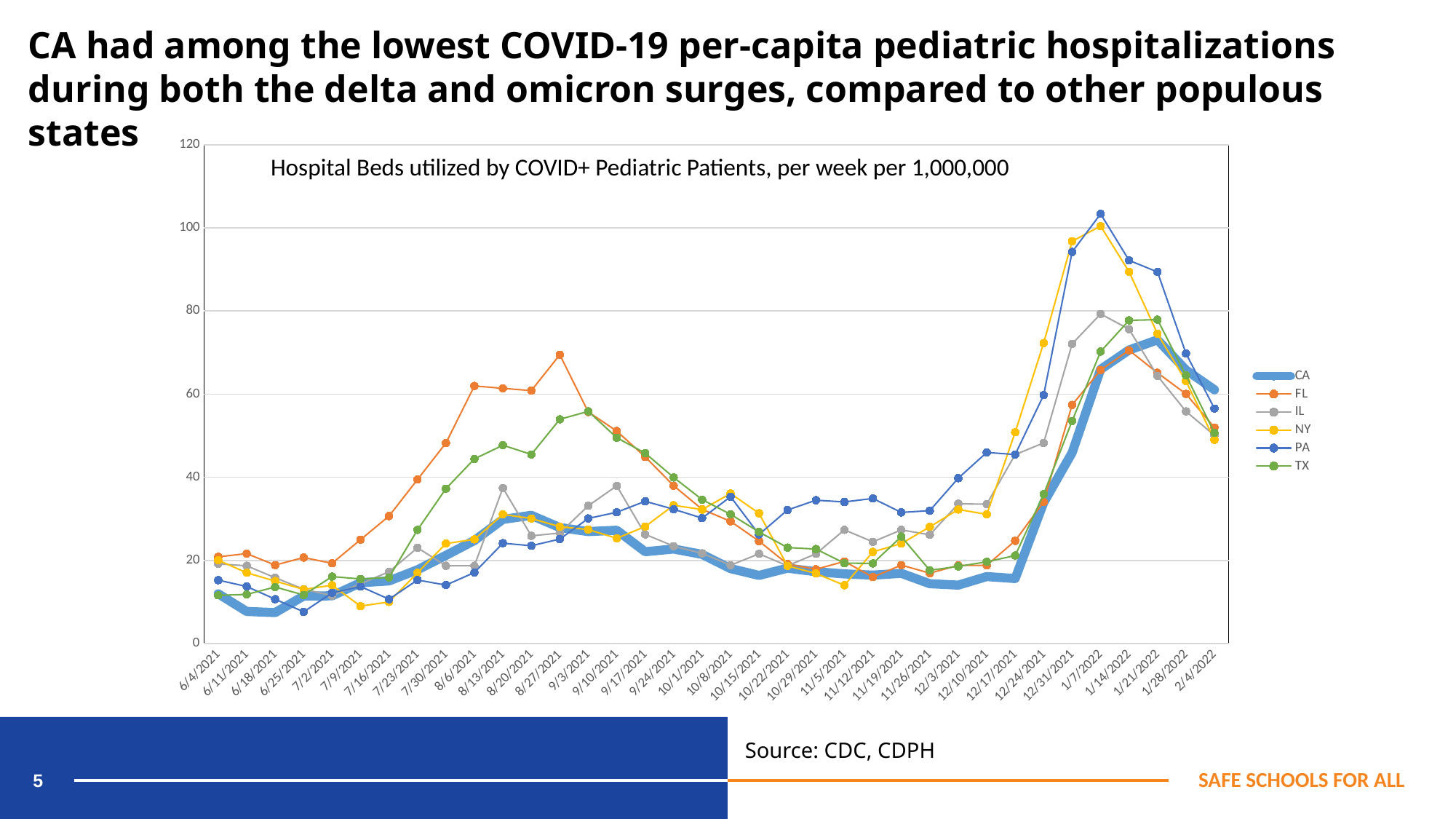
Is the value for FL on 8/27/2021 greater or less than 60? greater How many series does the legend list? 6 Is the value for PA on 1/7/2022 greater or less than 100? greater Which state has the highest value on 1/7/2022? PA What is the title of the chart? Hospital Beds utilized by COVID+ Pediatric Patients, per week per 1,000,000 What kind of chart is shown on the slide? Line chart How many weekly dates are shown on the x axis? 36 Which state has the highest value on 8/27/2021? FL Which states are listed in the chart legend? CA, FL, IL, NY, PA, TX On 8/6/2021, which is larger, the value for FL or the value for CA? FL Is the value for CA on 6/18/2021 greater or less than 20? less Which state has the lowest value on 12/17/2021? CA